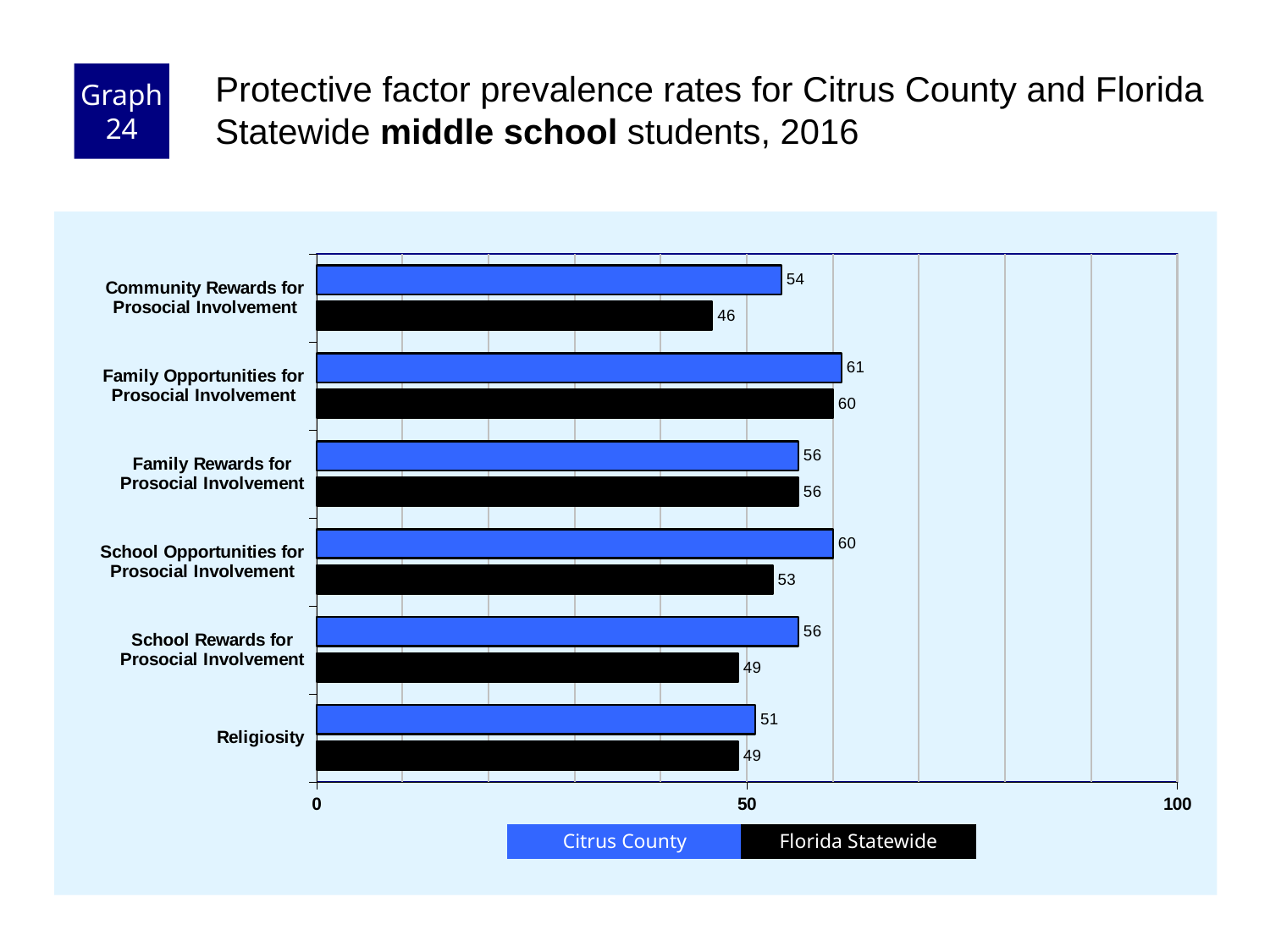
What kind of chart is shown on the slide? bar chart Which is larger for Community Rewards for Prosocial Involvement: the Citrus County value or the Florida Statewide value? Citrus County What colour are the Florida Statewide bars? black Is the Florida Statewide value for Religiosity greater or less than 50? less Which category has the lowest Florida Statewide value? Community Rewards for Prosocial Involvement Which category has the highest Citrus County value? Family Opportunities for Prosocial Involvement What is the Florida Statewide value for School Opportunities for Prosocial Involvement? 53 What is the Citrus County value for Family Opportunities for Prosocial Involvement? 61 How many categories are shown on the chart? 6 How many series does the legend list? 2 What is the difference between the Citrus County and Florida Statewide values for School Rewards for Prosocial Involvement? 7 What is the Florida Statewide value for Community Rewards for Prosocial Involvement? 46